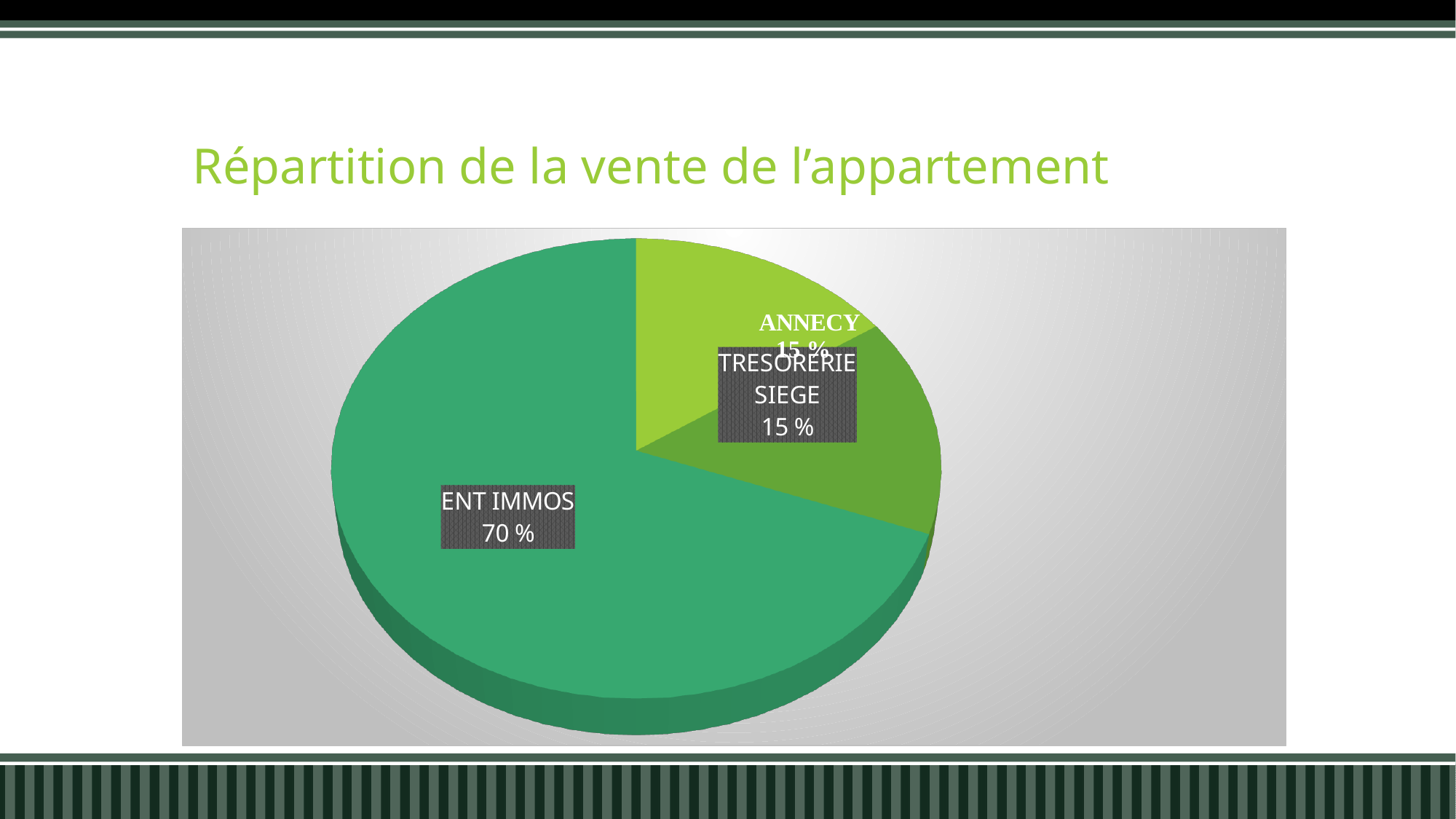
What percentage of the sale goes to ANNECY? 15 % What percentage of the sale goes to TRESORERIE SIEGE? 15 % What percentage of the sale goes to ENT IMMOS? 70 % Which is larger, the share for ENT IMMOS or the share for TRESORERIE SIEGE? ENT IMMOS Which category is shown in the darkest green slice? ENT IMMOS What is the title of the slide above the chart? Répartition de la vente de l'appartement What share of the pie does TRESORERIE SIEGE represent? 15 % How many slices does the pie chart have? 3 What kind of chart is shown on the slide? pie chart What is the difference between the ENT IMMOS share and the TRESORERIE SIEGE share? 55 % Which category has the largest share of the pie? ENT IMMOS Which is larger, the share for ENT IMMOS or the share for ANNECY? ENT IMMOS